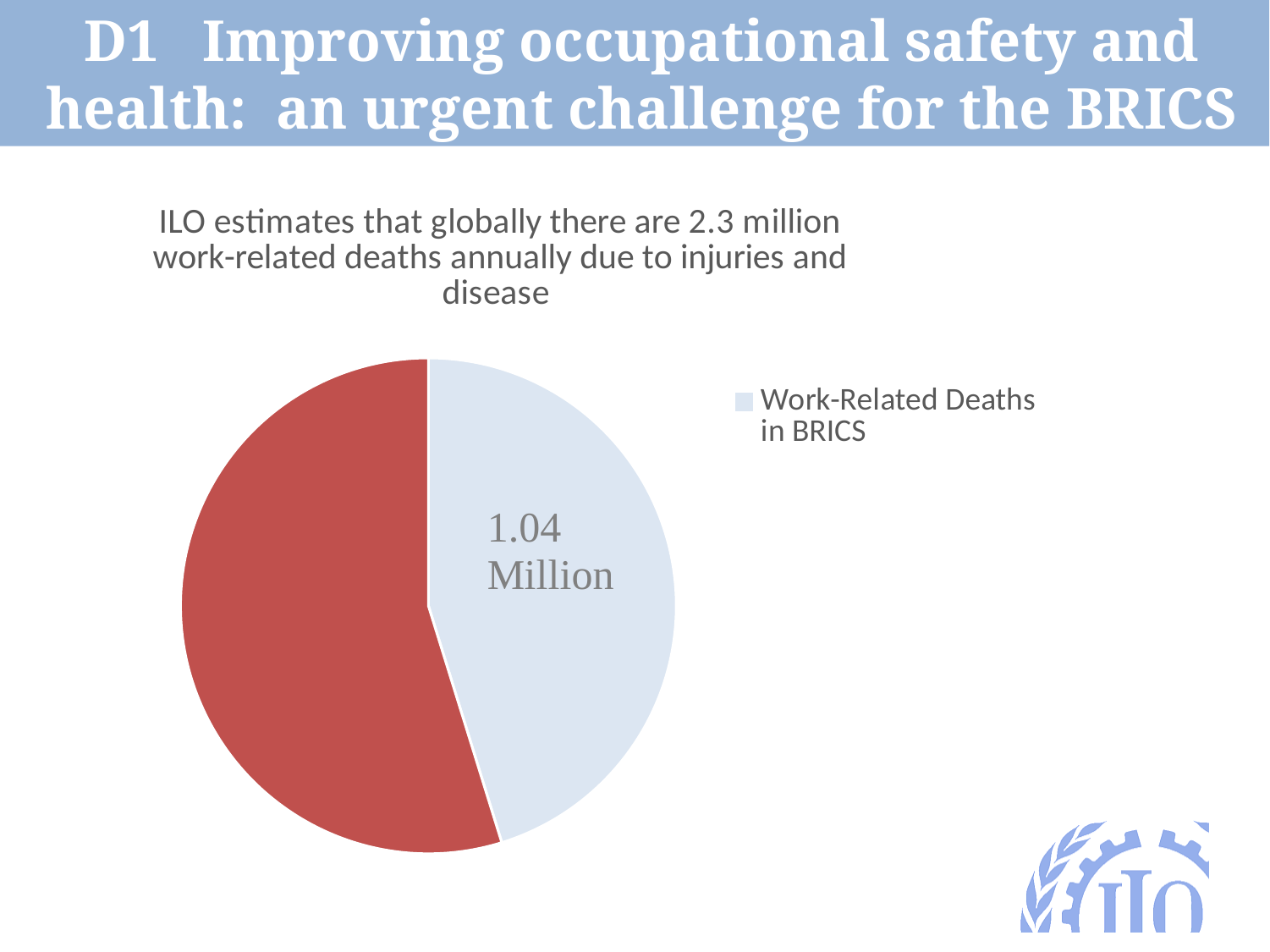
How many slices does the pie chart have? 2 What is the legend entry shown next to the pie chart? Work-Related Deaths in BRICS What kind of chart is shown on the slide? pie chart What colour is the slice labelled 1.04 Million? light blue Which slice of the pie chart is larger, the red slice or the light blue slice? the red slice What value is printed on the light blue slice of the pie chart? 1.04 Million How many entries does the legend of the pie chart list? 1 Which slice of the pie chart is the smallest? Work-Related Deaths in BRICS